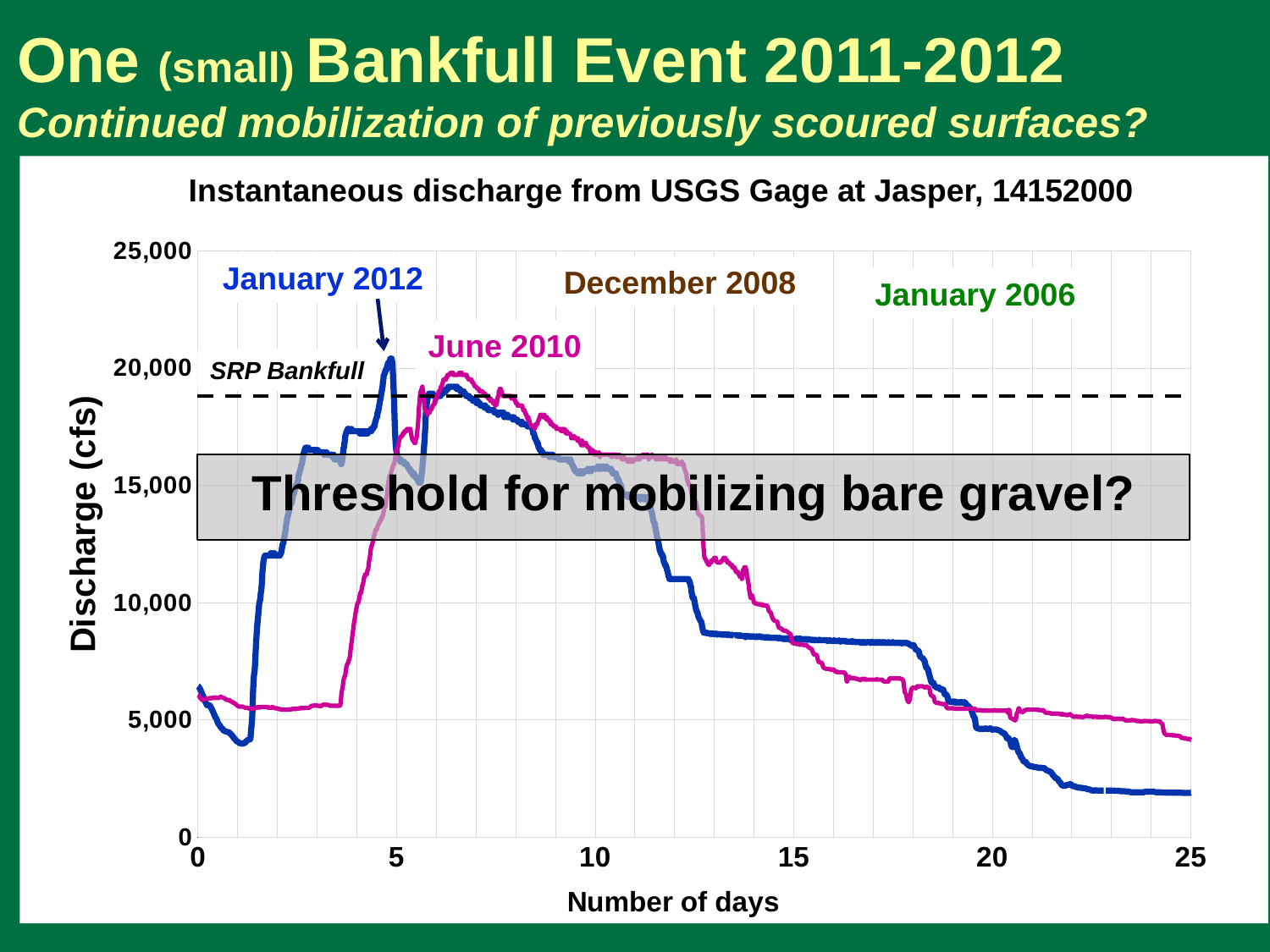
At day 25, which line shows the higher discharge, January 2012 or June 2010? June 2010 Is the June 2010 discharge at day 25 greater or less than 5,000? less Is the January 2012 discharge at day 25 greater or less than 5,000? less What is the highest value labelled on the vertical axis? 25,000 What is the label on the vertical axis of the chart? Discharge (cfs) What kind of chart is shown on the slide? line chart Is the peak discharge of the June 2010 line greater or less than 15,000? greater What does the dashed horizontal line on the chart represent? SRP Bankfull At day 2, which line shows the higher discharge, January 2012 or June 2010? January 2012 Between day 15 and day 25, does the January 2012 discharge rise or fall? fall